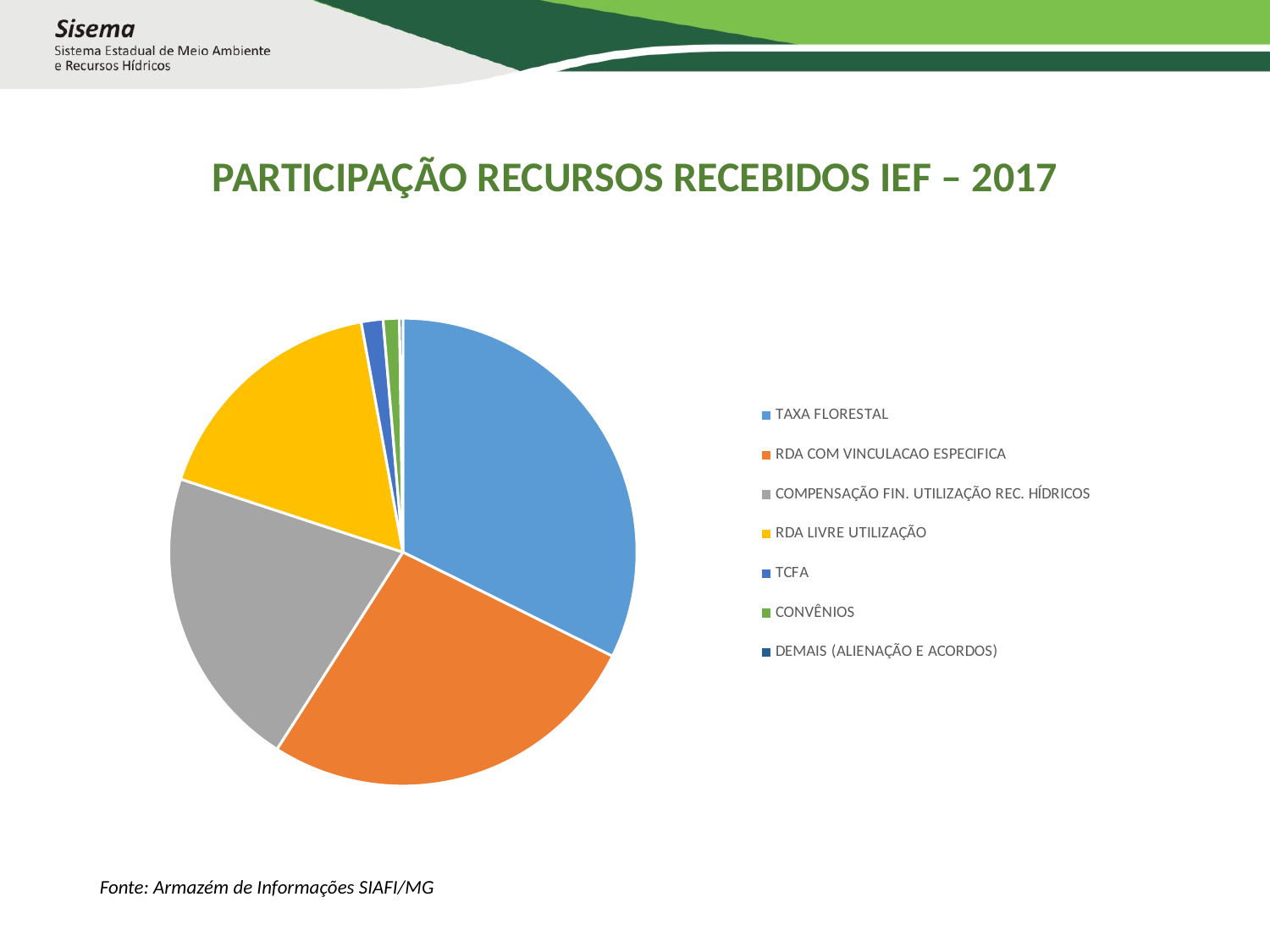
What colour is the TAXA FLORESTAL slice in the pie chart? blue Which slice is larger, COMPENSAÇÃO FIN. UTILIZAÇÃO REC. HÍDRICOS or TCFA? COMPENSAÇÃO FIN. UTILIZAÇÃO REC. HÍDRICOS Which slice is larger, RDA COM VINCULACAO ESPECIFICA or COMPENSAÇÃO FIN. UTILIZAÇÃO REC. HÍDRICOS? RDA COM VINCULACAO ESPECIFICA How many categories does the legend of the pie chart list? 7 What kind of chart is shown on the slide? pie chart Which slice is larger, RDA LIVRE UTILIZAÇÃO or CONVÊNIOS? RDA LIVRE UTILIZAÇÃO How many slices does the pie chart have? 7 What is the title of the chart on the slide? PARTICIPAÇÃO RECURSOS RECEBIDOS IEF – 2017 Which category has the largest slice of the pie chart? TAXA FLORESTAL